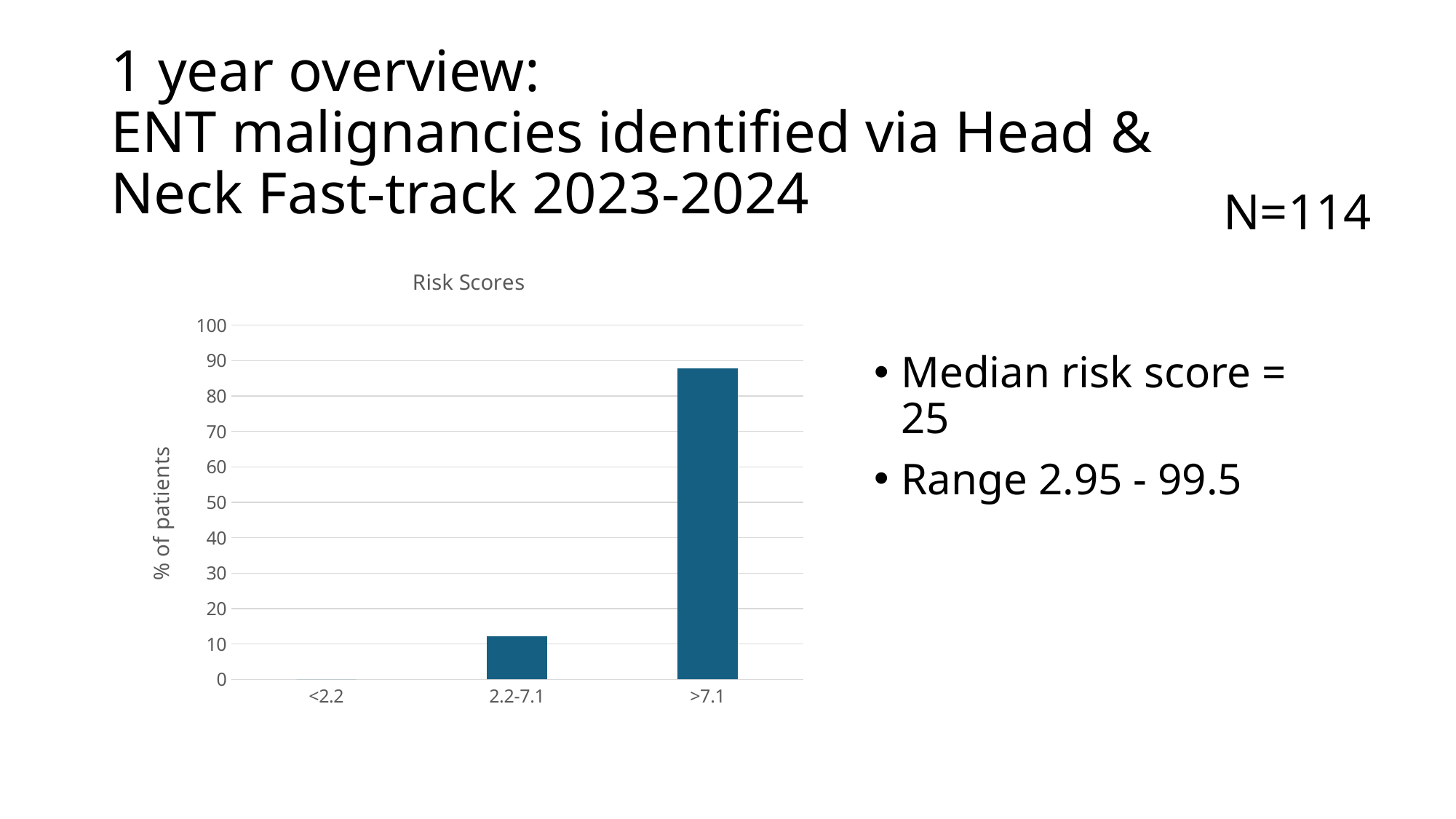
Is the percentage of patients in the 2.2-7.1 category greater or less than 20? less Is the percentage of patients in the 2.2-7.1 category greater or less than 30? less Do the values rise or fall moving from left to right along the x axis of the chart? rise Which risk score category has the highest percentage of patients? >7.1 How many risk score categories are shown on the x axis of the chart? 3 Which risk score category has the lowest percentage of patients? <2.2 What is the title of the chart? Risk Scores Is the percentage of patients in the >7.1 category greater or less than 50? greater What is the label on the vertical axis of the chart? % of patients What kind of chart is shown on the slide? bar chart Which has a higher percentage of patients, the 2.2-7.1 category or the >7.1 category? >7.1